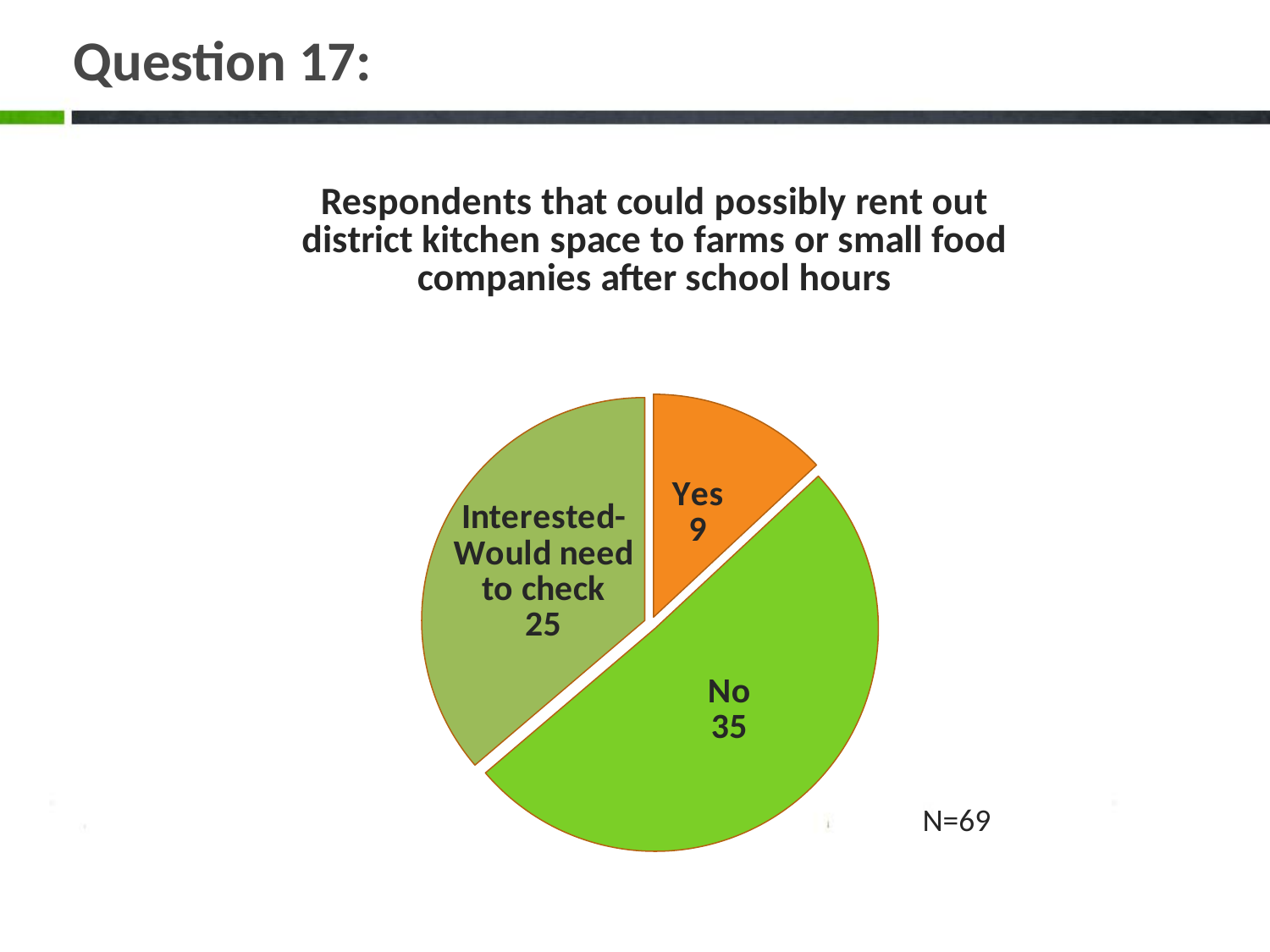
How many respondents answered "Interested- Would need to check"? 25 How many slices does the pie chart have? 3 What is the total number of respondents shown on the slide (N)? 69 What colour is the "Yes" slice? Orange How many respondents answered "No"? 35 What is the difference between the "No" and "Interested- Would need to check" counts? 10 What kind of chart is shown on the slide? Pie chart What is the difference between the number of "No" responses and "Yes" responses? 26 Which response has the largest slice of the pie? No Which is larger: the "Interested- Would need to check" slice or the "Yes" slice? Interested- Would need to check How many respondents answered "Yes"? 9 Which response has the smallest slice of the pie? Yes